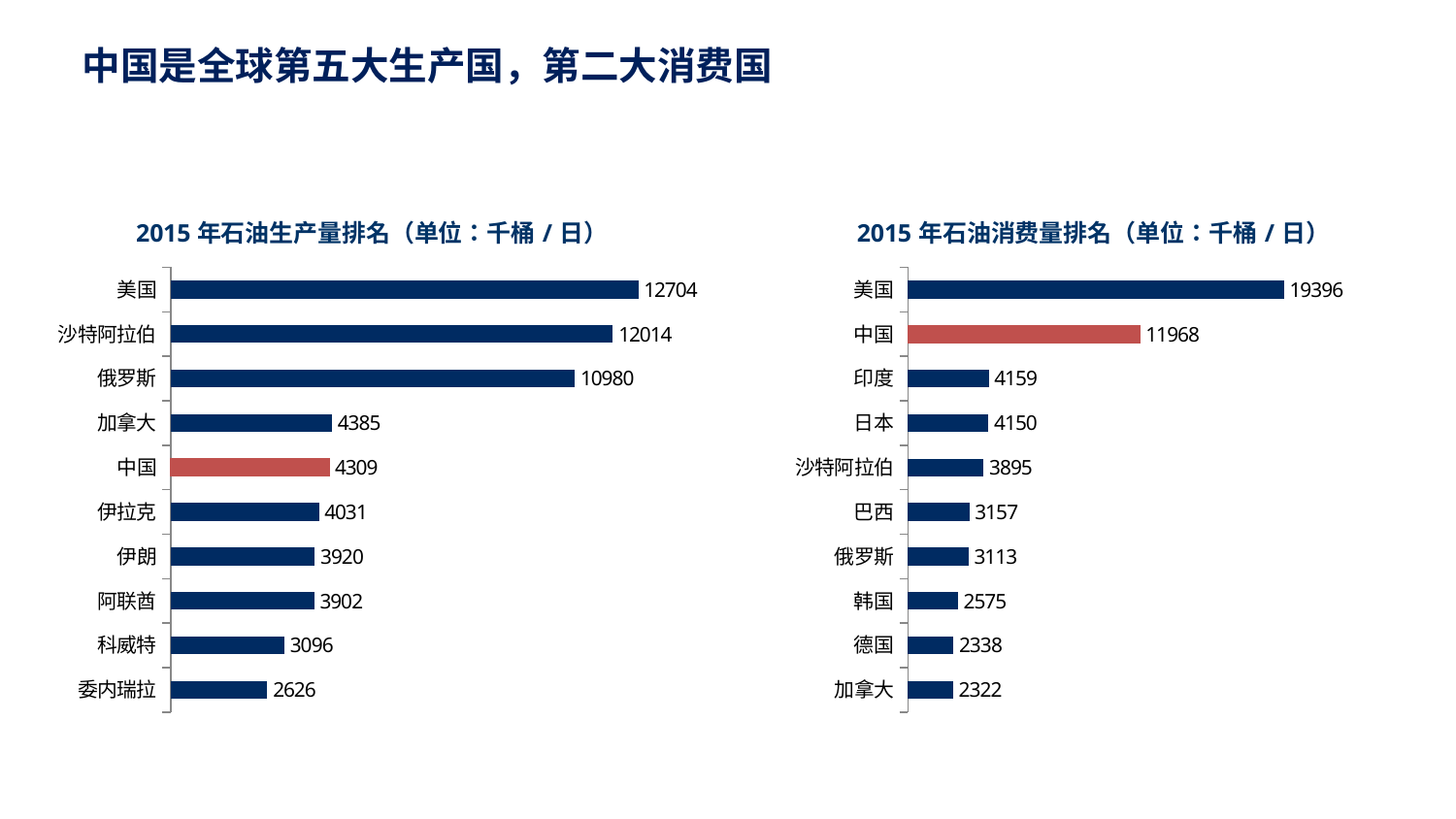
In the 2015 年石油生产量排名 chart, which country has the highest value? 美国 In the 2015 年石油消费量排名 chart, which country's bar is highlighted in red? 中国 What kind of chart is the 2015 年石油消费量排名 chart? Bar chart In the 2015 年石油消费量排名 chart, which is larger, 巴西 or 韩国? 巴西 In the 2015 年石油生产量排名 chart, what is the value for 中国? 4309 In the 2015 年石油消费量排名 chart, what is the difference between 美国 and 中国? 7428 How many countries are shown in the 2015 年石油生产量排名 chart? 10 In the 2015 年石油消费量排名 chart, which country has the lowest value? 加拿大 In the 2015 年石油生产量排名 chart, what is the value for 委内瑞拉? 2626 In the 2015 年石油生产量排名 chart, which is larger, 俄罗斯 or 加拿大? 俄罗斯 In the 2015 年石油消费量排名 chart, what is the value for 印度? 4159 In the 2015 年石油生产量排名 chart, what is the difference between 美国 and 沙特阿拉伯? 690